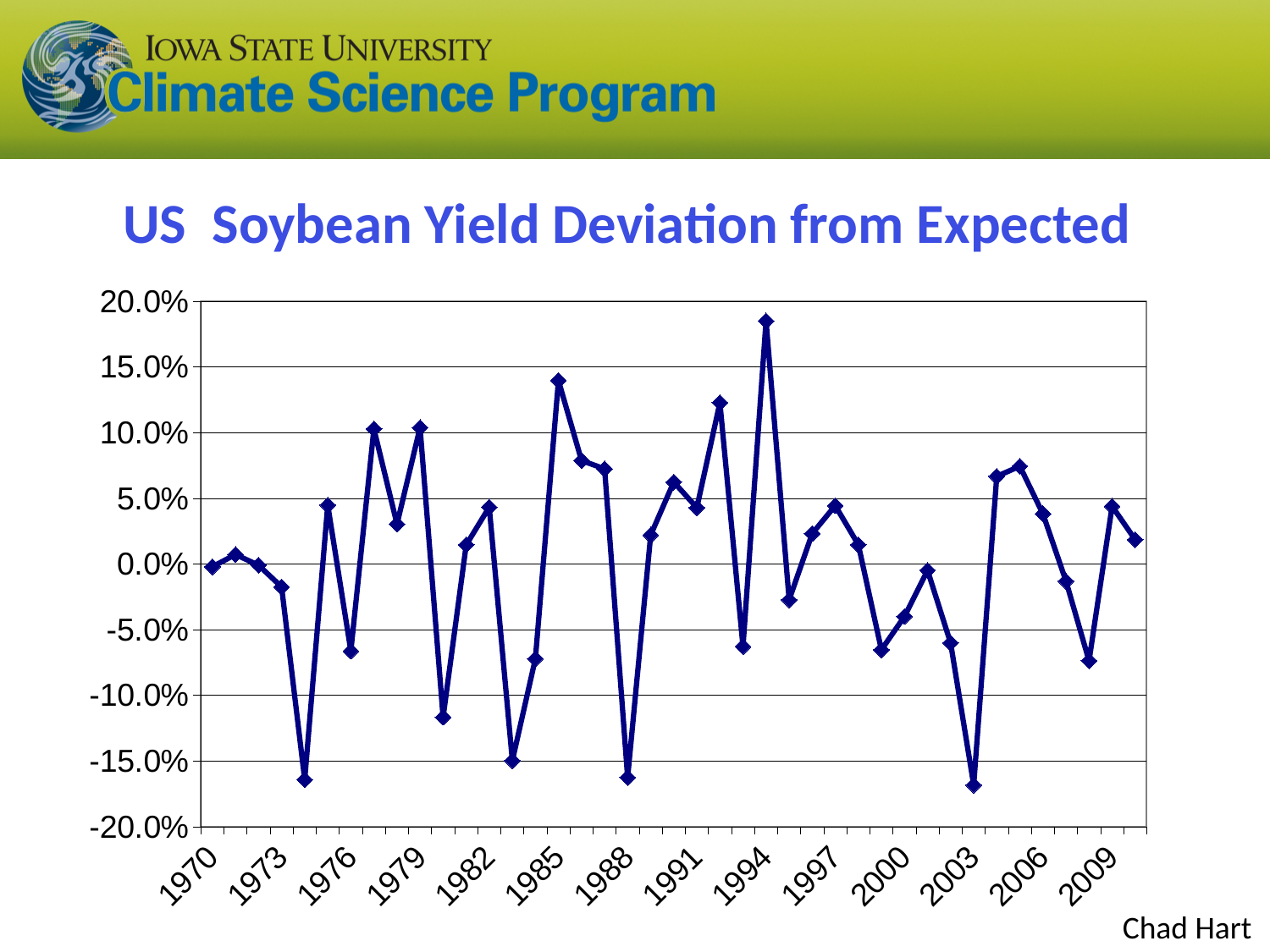
Is the value for 2003 greater or less than -15.0%? less Is the value for 1988 greater or less than -15.0%? less Is the value for 1985 greater or less than 10.0%? greater What is the title of the chart? US Soybean Yield Deviation from Expected Which year has the larger yield deviation, 1994 or 1985? 1994 What kind of chart is shown on the slide? line chart Which year has the larger yield deviation, 1974 or 1975? 1975 Does the yield deviation rise or fall from 1994 to 1995? fall Which year has the highest soybean yield deviation? 1994